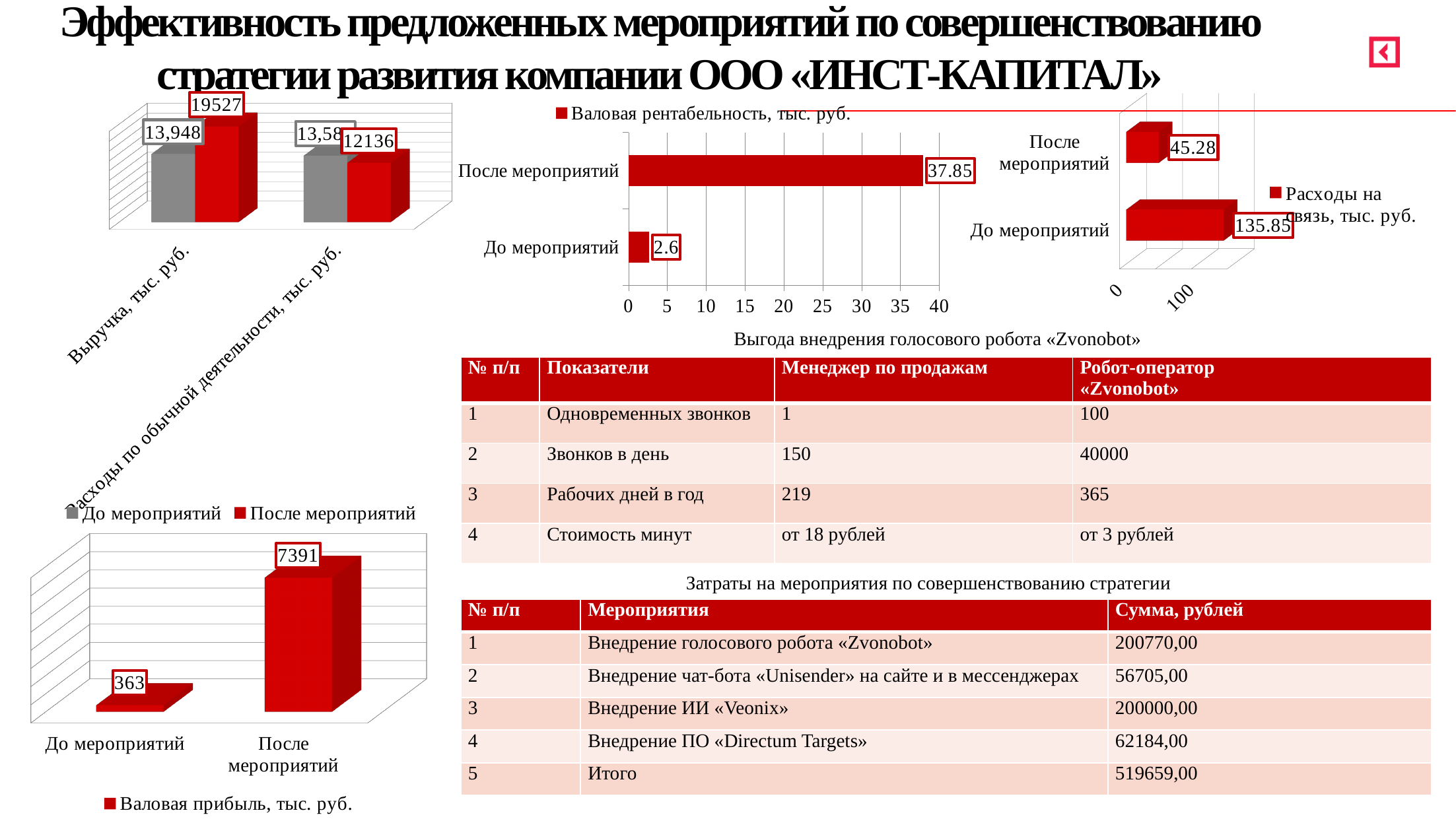
In the chart with legend 'Валовая рентабельность, тыс. руб.', what is the value for 'После мероприятий'? 37.85 In the top-left chart, what is the 'После мероприятий' value for 'Расходы по обычной деятельности, тыс. руб.'? 12136 In the chart with legend 'Расходы на связь, тыс. руб.', which category has the lower value? После мероприятий In the chart with legend 'Валовая прибыль, тыс. руб.', what is the value for 'После мероприятий'? 7391 How many series does the legend of the top-left chart list? 2 In the chart with legend 'Валовая рентабельность, тыс. руб.', what is the value for 'До мероприятий'? 2.6 In the chart with legend 'Валовая прибыль, тыс. руб.', what is the difference between the 'После мероприятий' and 'До мероприятий' values? 7028 In the top-left chart, what is the 'После мероприятий' value for 'Выручка, тыс. руб.'? 19527 In the chart with legend 'Валовая рентабельность, тыс. руб.', what is the difference between the 'После мероприятий' and 'До мероприятий' values? 35.25 In the chart with legend 'Расходы на связь, тыс. руб.', what is the value for 'После мероприятий'? 45.28 In the chart with legend 'Валовая прибыль, тыс. руб.', what is the value for 'До мероприятий'? 363 In the chart with legend 'Расходы на связь, тыс. руб.', what is the value for 'До мероприятий'? 135.85